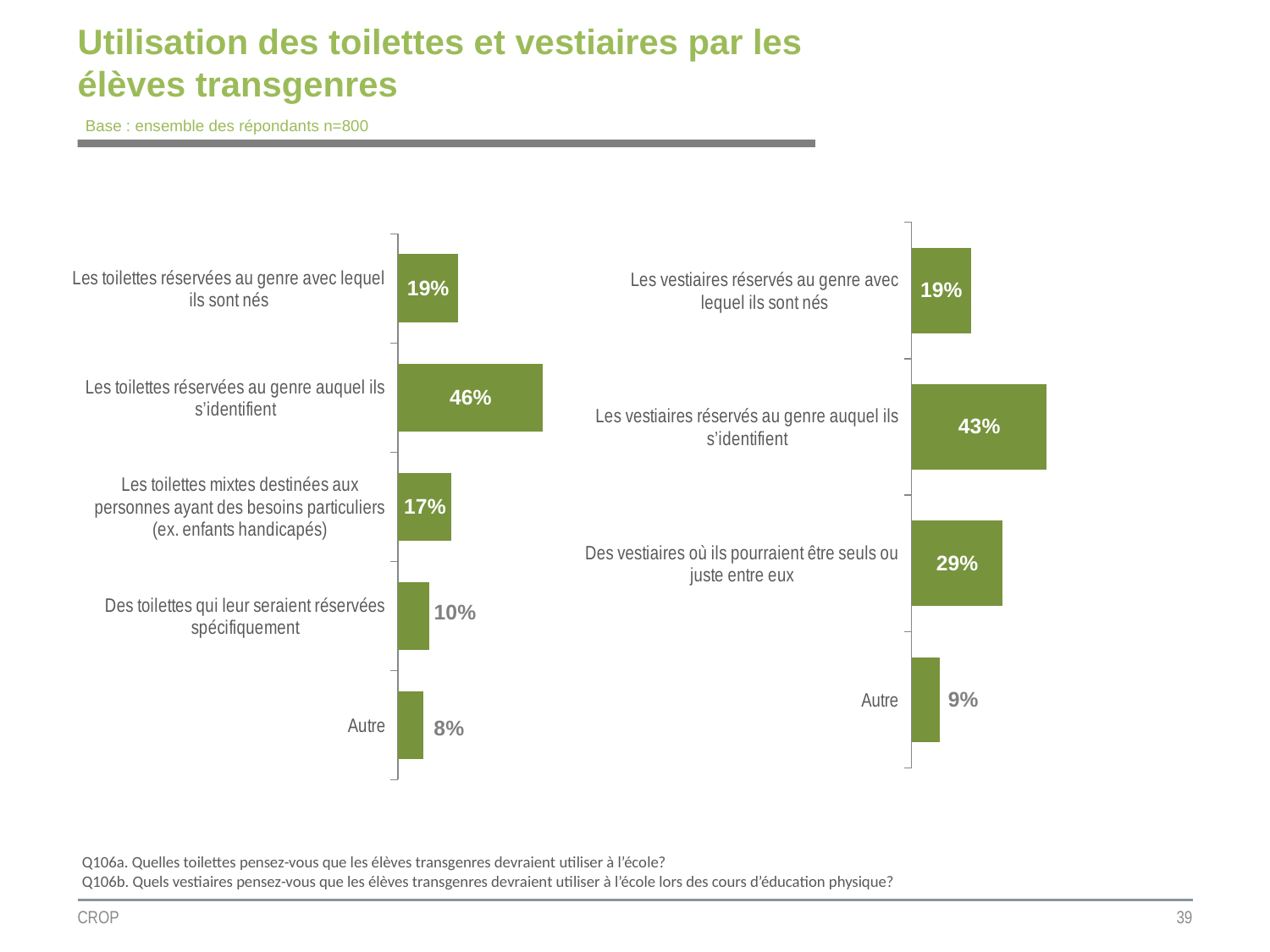
How many categories does the left chart (toilettes) show? 5 In the left chart (toilettes), which is larger: "Les toilettes mixtes destinées aux personnes ayant des besoins particuliers" or "Des toilettes qui leur seraient réservées spécifiquement"? Les toilettes mixtes destinées aux personnes ayant des besoins particuliers In the right chart (vestiaires), what is the value for "Des vestiaires où ils pourraient être seuls ou juste entre eux"? 29% In the left chart (toilettes), what is the value for "Autre"? 8% What is the base (number of respondents) stated on the slide? n=800 How many categories does the right chart (vestiaires) show? 4 In the left chart (toilettes), which category has the lowest value? Autre What type of chart is the right chart (vestiaires)? Bar chart In the right chart (vestiaires), which category has the highest value? Les vestiaires réservés au genre auquel ils s'identifient In the right chart (vestiaires), what is the difference between "Les vestiaires réservés au genre auquel ils s'identifient" and "Des vestiaires où ils pourraient être seuls ou juste entre eux"? 14 percentage points In the left chart (toilettes), what is the difference between "Les toilettes réservées au genre auquel ils s'identifient" and "Les toilettes réservées au genre avec lequel ils sont nés"? 27 percentage points In the left chart (toilettes), what is the value for "Les toilettes réservées au genre auquel ils s'identifient"? 46%